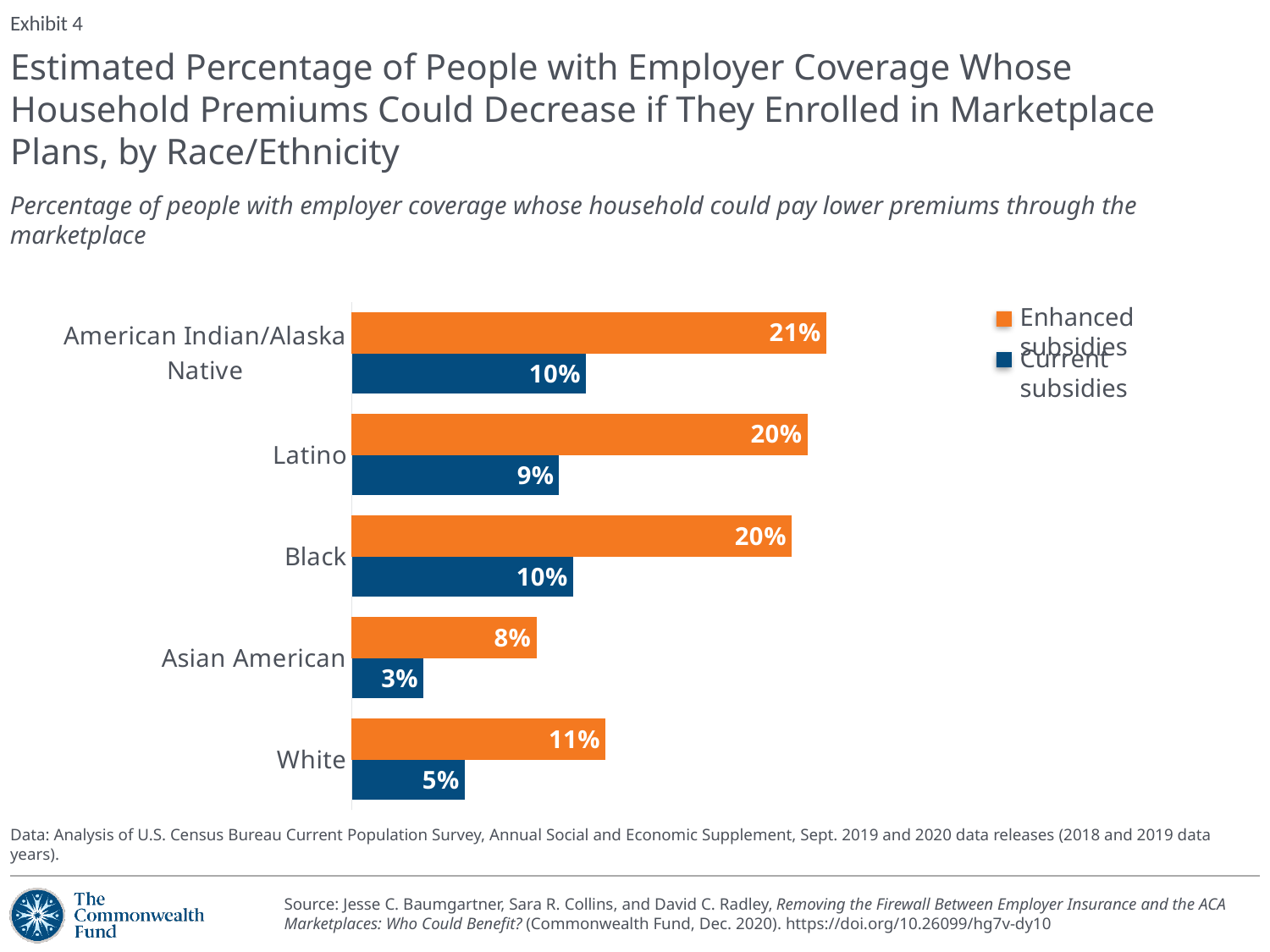
Which race/ethnicity group has the highest Enhanced subsidies value? American Indian/Alaska Native How many series does the legend list? 2 What is the Enhanced subsidies value for White? 11% What kind of chart is shown on the slide? Bar chart Which colour represents the Current subsidies series? Blue Which is larger: the Current subsidies value for White or the Current subsidies value for Latino? Latino What is the difference between the Enhanced subsidies and Current subsidies values for Black? 10% What is the Current subsidies value for Asian American? 3% What is the difference between the Enhanced subsidies values for American Indian/Alaska Native and White? 10% Which race/ethnicity group has the lowest Current subsidies value? Asian American What is the Enhanced subsidies value for Latino? 20% How many race/ethnicity categories are shown in the chart? 5